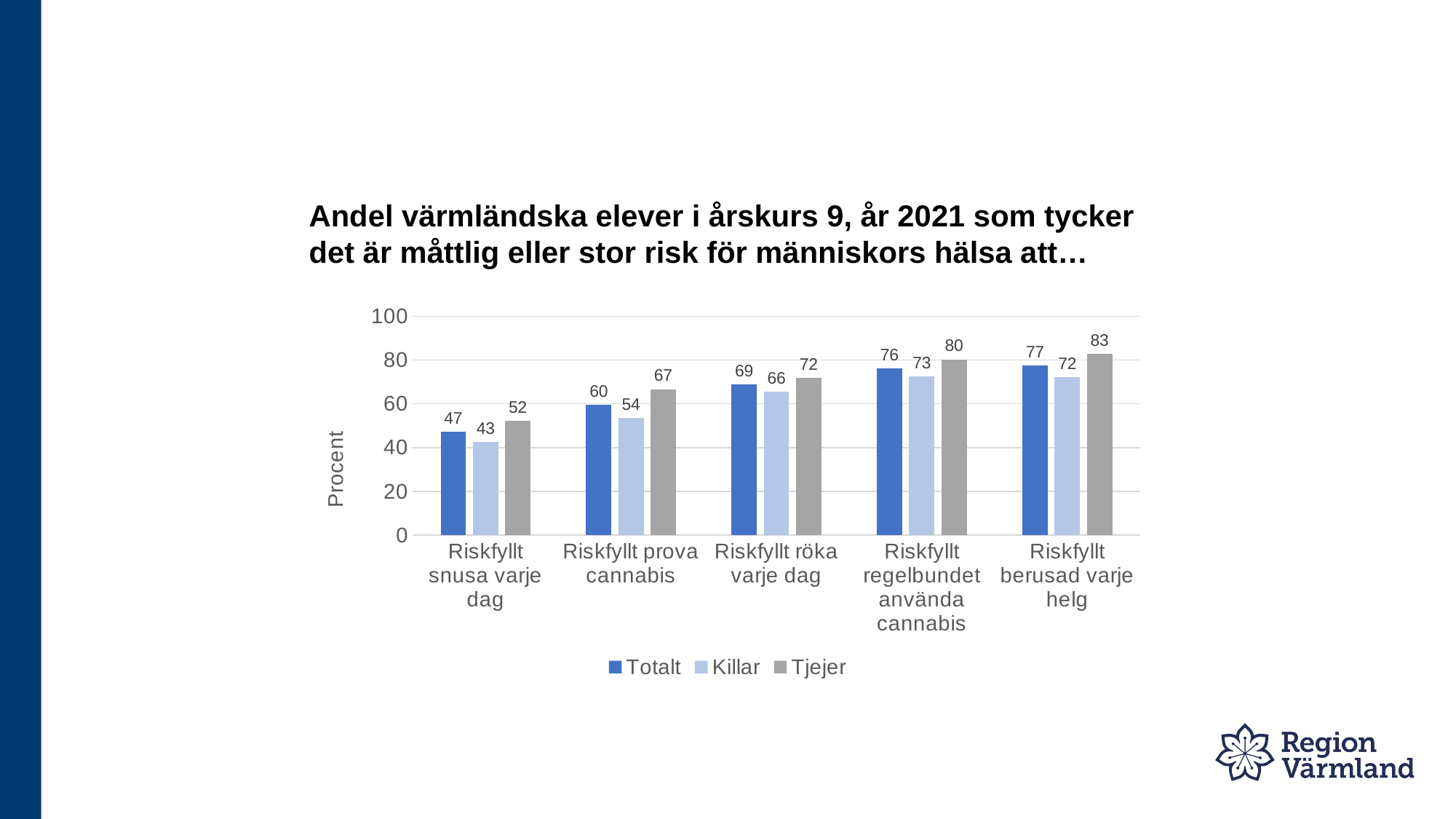
How many series does the legend list? 3 What is the label of the y axis? Procent What is the Tjejer value for "Riskfyllt berusad varje helg"? 83 Which is larger for "Riskfyllt röka varje dag": the Killar value or the Tjejer value? Tjejer Which category has the lowest Killar value? Riskfyllt snusa varje dag How many categories are shown on the x axis? 5 What is the Totalt value for "Riskfyllt snusa varje dag"? 47 What is the Killar value for "Riskfyllt prova cannabis"? 54 What is the difference between the Tjejer and Killar values for "Riskfyllt regelbundet använda cannabis"? 7 Which category has the highest Tjejer value? Riskfyllt berusad varje helg Is the Totalt value for "Riskfyllt prova cannabis" greater or less than 80? less What kind of chart is shown on the slide? Bar chart